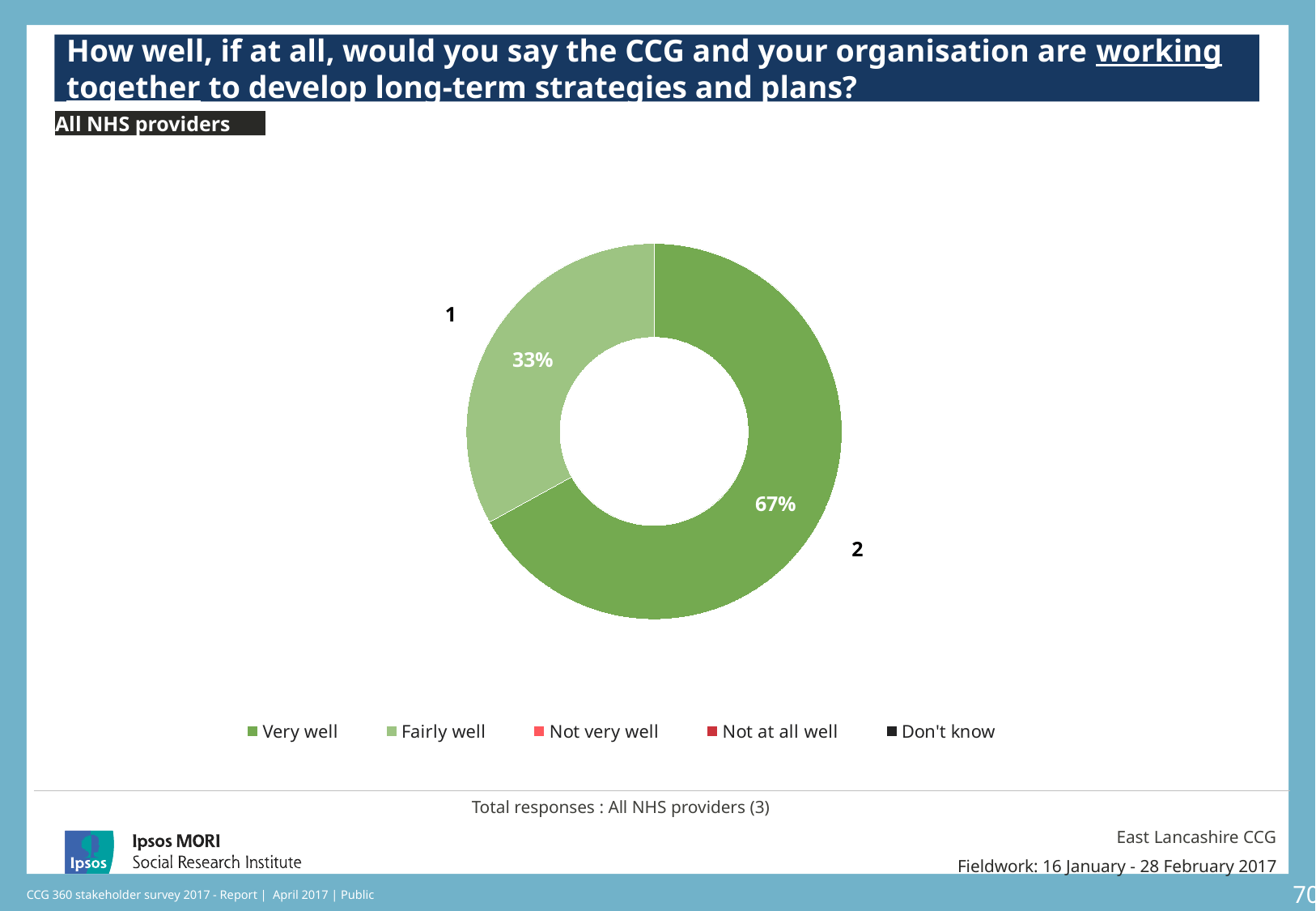
Which response category has the largest share of the chart? Very well How many respondents gave the 'Very well' answer, according to the number label next to the slice? 2 What is the difference in percentage points between 'Very well' and 'Fairly well'? 34 percentage points What is the total number of responses shown for All NHS providers? 3 Which is larger, the share for 'Very well' or the share for 'Fairly well'? Very well What kind of chart is shown on the slide? Donut (pie) chart Which colour represents 'Very well' in the legend? Dark green What percentage of respondents said 'Fairly well'? 33% How many response categories have a visible slice in the chart? 2 Which of the two plotted response categories has the smaller share? Fairly well What percentage of respondents said 'Very well'? 67% How many response categories does the legend list? 5